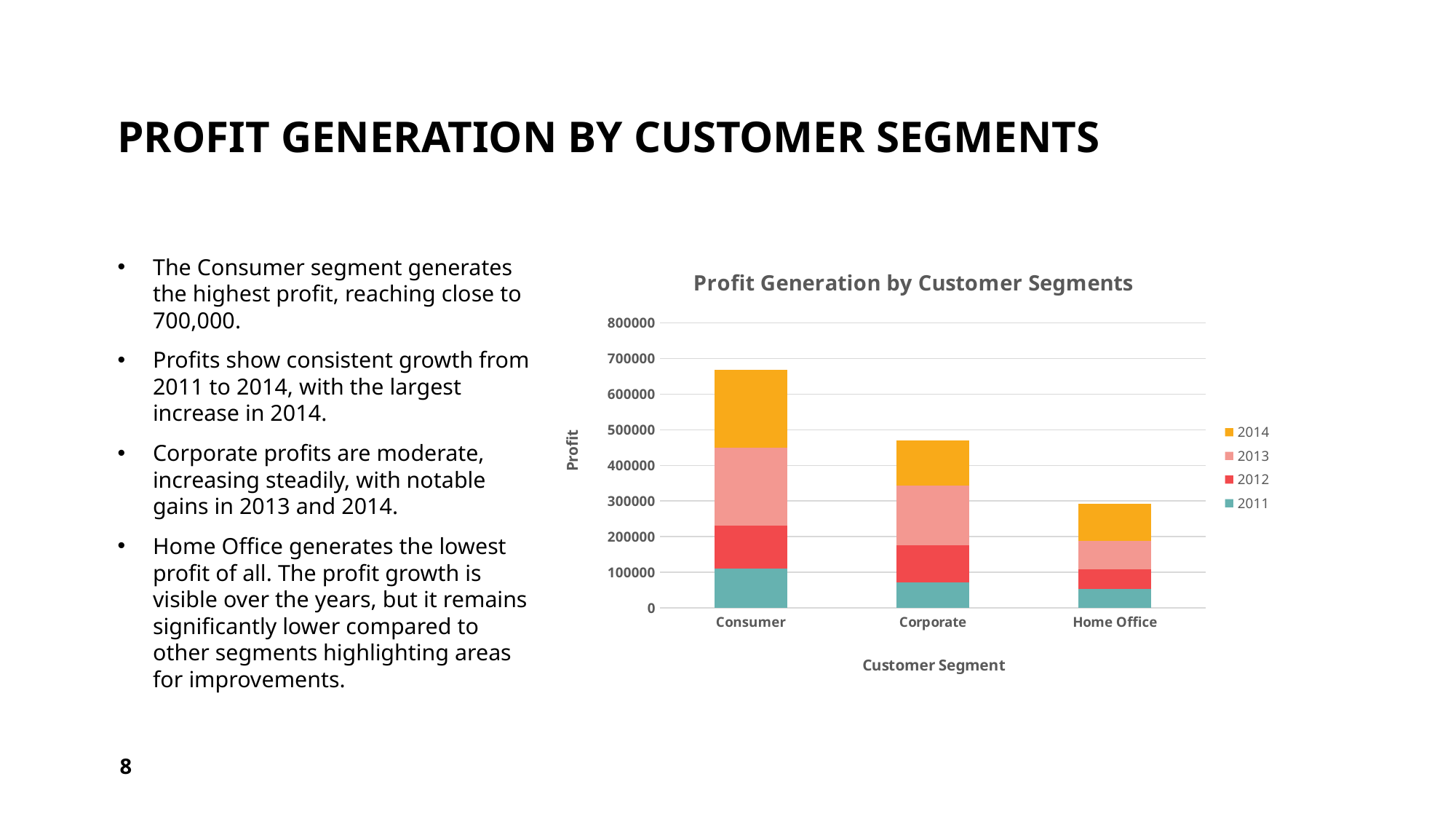
Which has a larger total profit, Corporate or Home Office? Corporate How many series does the legend list? 4 Which customer segment has the highest total profit? Consumer What is the title of the chart? Profit Generation by Customer Segments Is the total profit for Home Office greater or less than 200000? greater What kind of chart is shown on the slide? Stacked bar chart Is the total profit for Consumer greater or less than 600000? greater Which customer segment has the lowest total profit? Home Office Is the total profit for Corporate greater or less than 400000? greater How many customer segments are shown on the x axis? 3 Which years are listed in the chart legend? 2014, 2013, 2012, 2011